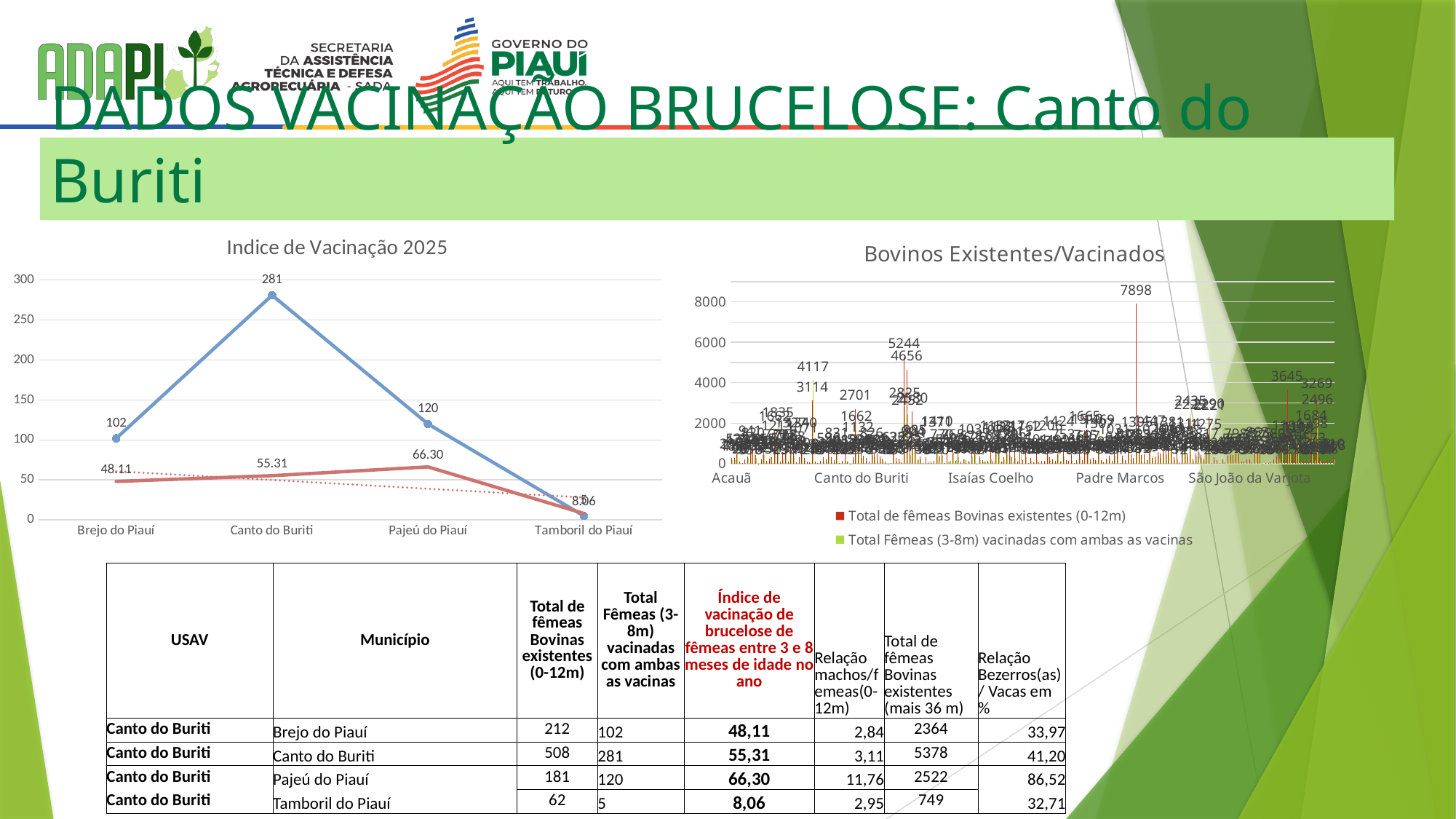
In the 'Bovinos Existentes/Vacinados' chart, what is the highest data label shown? 7898 How many series does the legend of the 'Bovinos Existentes/Vacinados' chart list? 2 In the 'Indice de Vacinação 2025' chart, what is the value of the red line for Pajeú do Piauí? 66.30 What kind of chart is the 'Bovinos Existentes/Vacinados' chart? bar chart In the 'Indice de Vacinação 2025' chart, which municipality has the highest value on the blue line? Canto do Buriti In the 'Indice de Vacinação 2025' chart, which municipality has the lowest value on the red line? Tamboril do Piauí In the 'Indice de Vacinação 2025' chart, which is larger on the red line: Canto do Buriti or Pajeú do Piauí? Pajeú do Piauí In the 'Indice de Vacinação 2025' chart, what is the difference between the blue line values for Canto do Buriti and Pajeú do Piauí? 161 How many municipalities are shown on the x axis of the 'Indice de Vacinação 2025' chart? 4 What kind of chart is the 'Indice de Vacinação 2025' chart? line chart In the 'Indice de Vacinação 2025' chart, what is the value of the blue line for Brejo do Piauí? 102 In the 'Indice de Vacinação 2025' chart, what is the value of the blue line for Canto do Buriti? 281